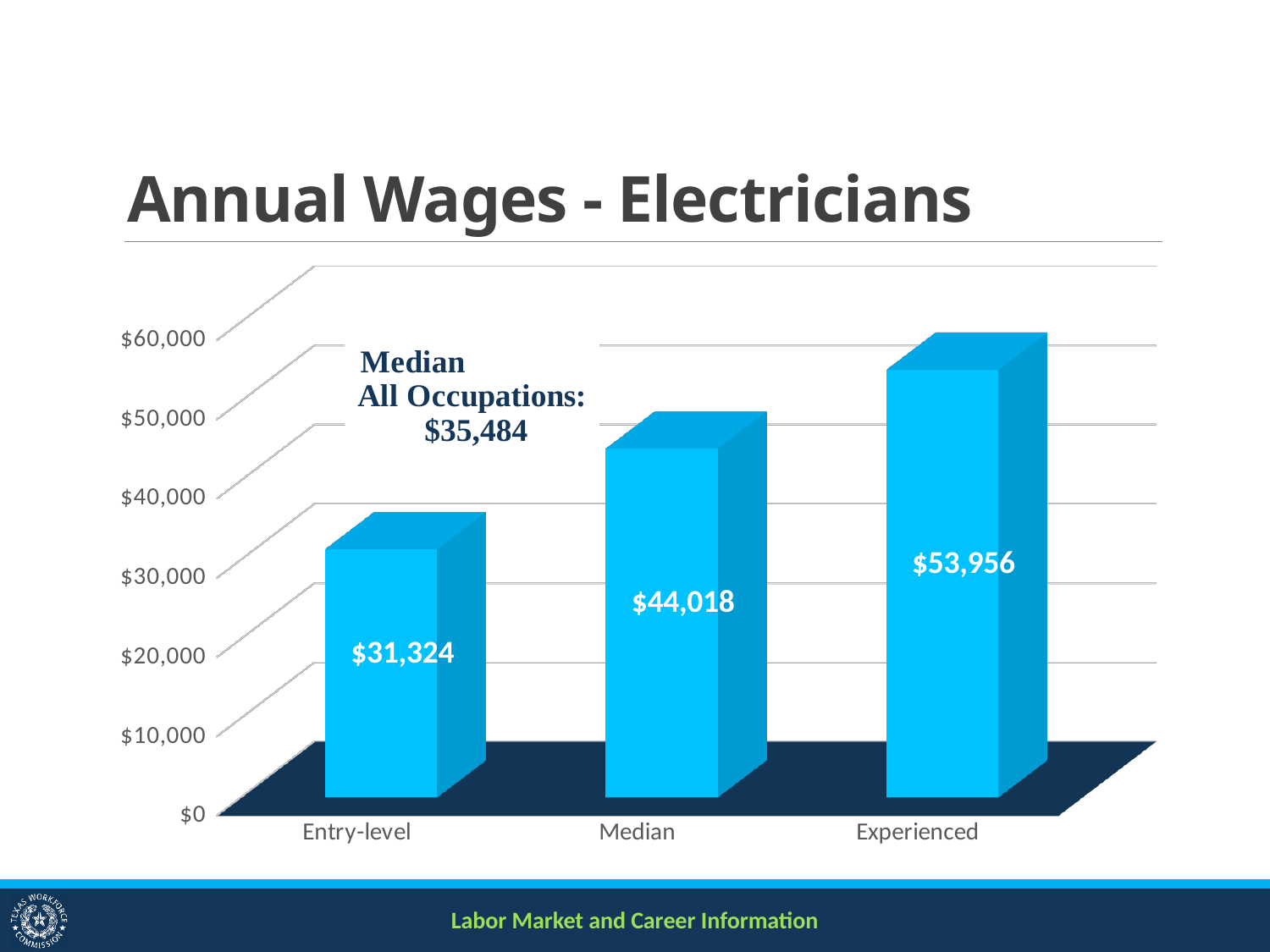
Which is larger, the Median wage or the Entry-level wage? Median Do the values rise or fall from Entry-level to Experienced? Rise What is the Median wage for All Occupations noted on the chart? $35,484 What is the difference between the Median and Entry-level annual wages? $12,694 What is the difference between the Experienced and Entry-level annual wages? $22,632 Which category has the lowest annual wage? Entry-level How many categories are shown on the x axis? 3 Which category has the highest annual wage? Experienced What kind of chart is shown on the slide? Bar chart What is the annual wage for Experienced electricians? $53,956 What is the Median annual wage for electricians? $44,018 What is the annual wage for Entry-level electricians? $31,324